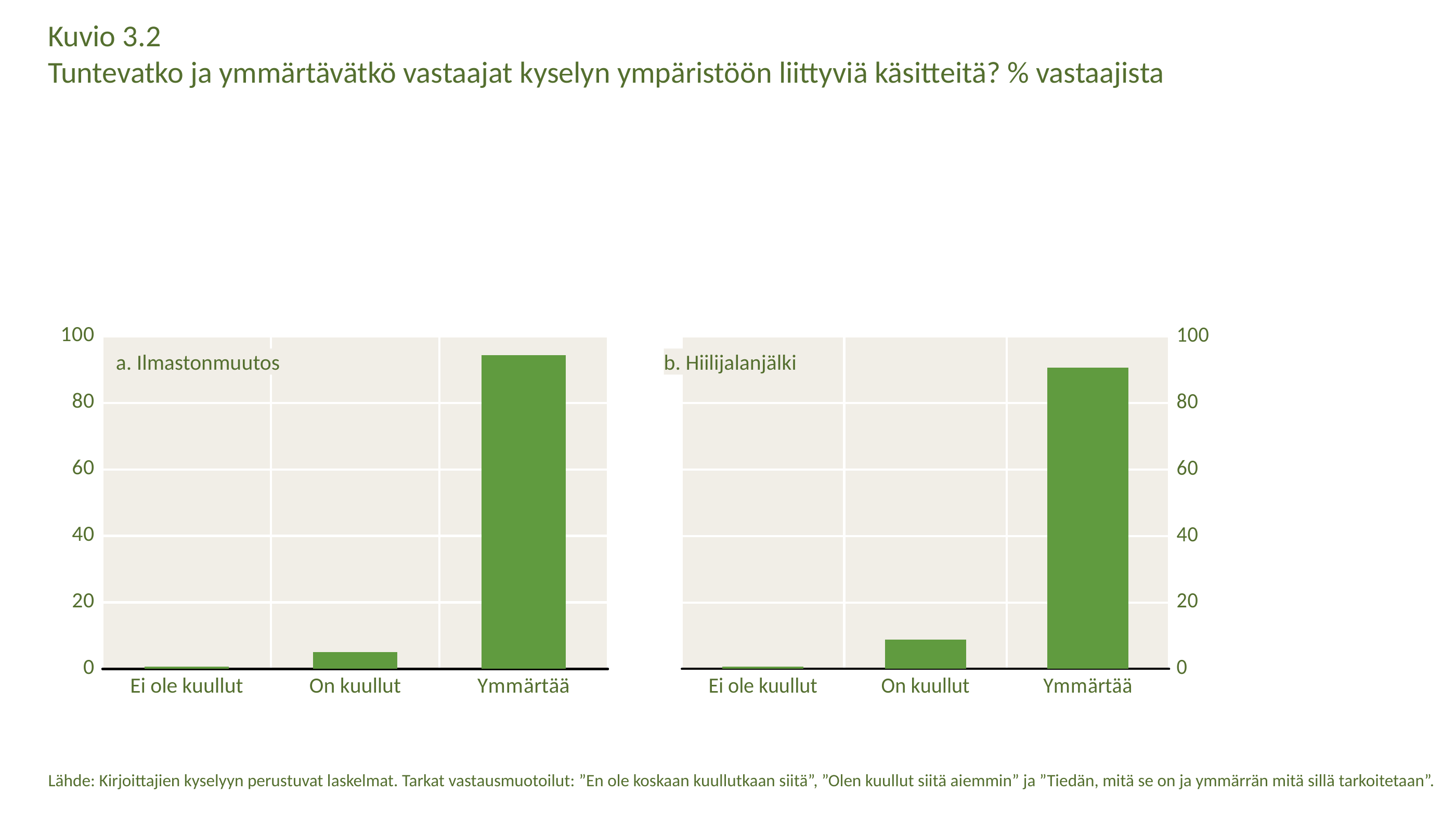
What is the figure number given in the slide title? Kuvio 3.2 Which is larger: On kuullut in the "a. Ilmastonmuutos" chart or On kuullut in the "b. Hiilijalanjälki" chart? b. Hiilijalanjälki In the "b. Hiilijalanjälki" chart, which category has the lowest value? Ei ole kuullut How many categories are shown on the x axis of the "b. Hiilijalanjälki" chart? 3 In the "b. Hiilijalanjälki" chart, do the values rise or fall from left to right along the x axis? rise In the "a. Ilmastonmuutos" chart, is the value for On kuullut greater or less than 20? less What kind of chart is "a. Ilmastonmuutos"? bar chart Which is larger: Ymmärtää in the "a. Ilmastonmuutos" chart or Ymmärtää in the "b. Hiilijalanjälki" chart? a. Ilmastonmuutos In the "b. Hiilijalanjälki" chart, is the value for On kuullut greater or less than 20? less In the "a. Ilmastonmuutos" chart, is the value for Ymmärtää greater or less than 80? greater In the "a. Ilmastonmuutos" chart, which category has the highest value? Ymmärtää